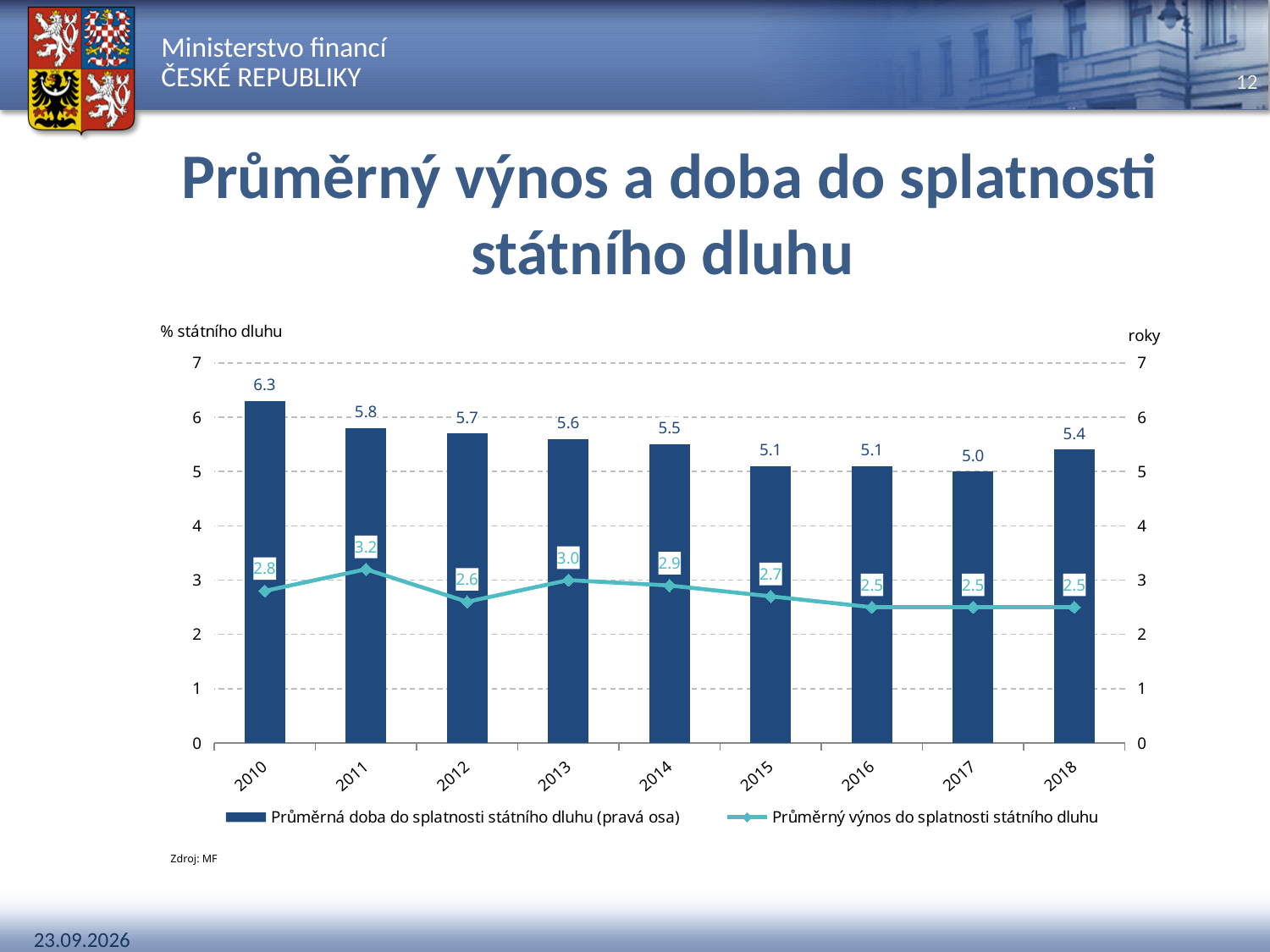
What is the difference between Průměrná doba do splatnosti státního dluhu (pravá osa) in 2010 and in 2011? 0.5 In which year is Průměrný výnos do splatnosti státního dluhu the highest? 2011 Which is larger, Průměrný výnos do splatnosti státního dluhu in 2013 or in 2012? 2013 How many years are shown on the x axis? 9 Does Průměrný výnos do splatnosti státního dluhu rise or fall from 2014 to 2016? fall What kind of chart is shown on the slide? Combined bar and line chart What is the value of Průměrný výnos do splatnosti státního dluhu in 2011? 3.2 In which year is Průměrná doba do splatnosti státního dluhu (pravá osa) the lowest? 2017 What is the value of Průměrná doba do splatnosti státního dluhu (pravá osa) in 2010? 6.3 What is the value of Průměrná doba do splatnosti státního dluhu (pravá osa) in 2018? 5.4 How many series does the legend list? 2 In which year is Průměrná doba do splatnosti státního dluhu (pravá osa) the highest? 2010